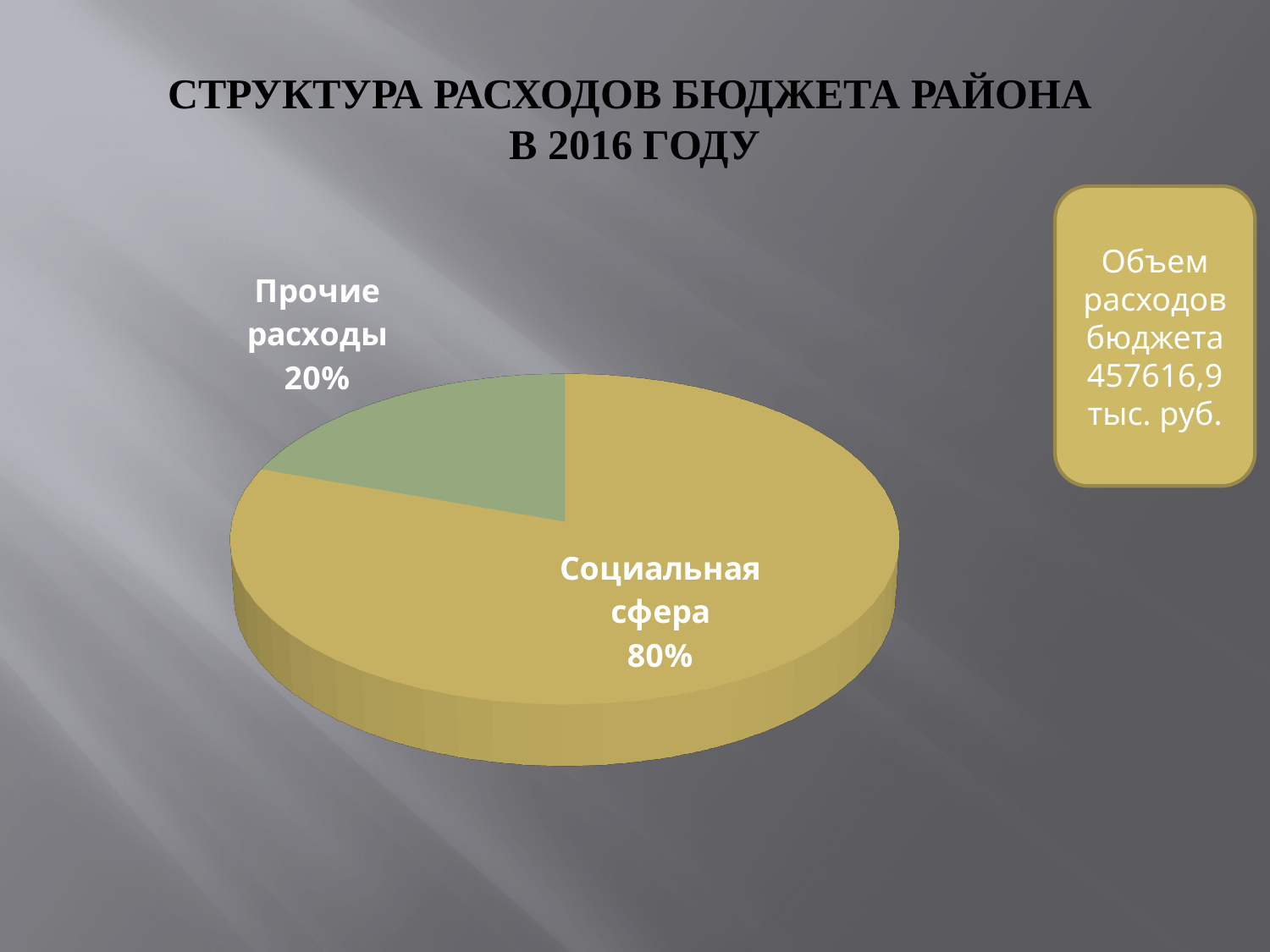
How many slices does the pie chart have? 2 What share of the pie does Прочие расходы take? 20% What colour is the Прочие расходы slice? Green What is the difference in percentage points between Социальная сфера and Прочие расходы? 60 Which slice of the pie is the largest? Социальная сфера Which is larger, Социальная сфера or Прочие расходы? Социальная сфера What kind of chart is shown on the slide? Pie chart Which slice of the pie is the smallest? Прочие расходы What share of the pie does Социальная сфера take? 80% Is the share for Прочие расходы greater or less than 50%? less What is the title of the chart on the slide? СТРУКТУРА РАСХОДОВ БЮДЖЕТА РАЙОНА В 2016 ГОДУ